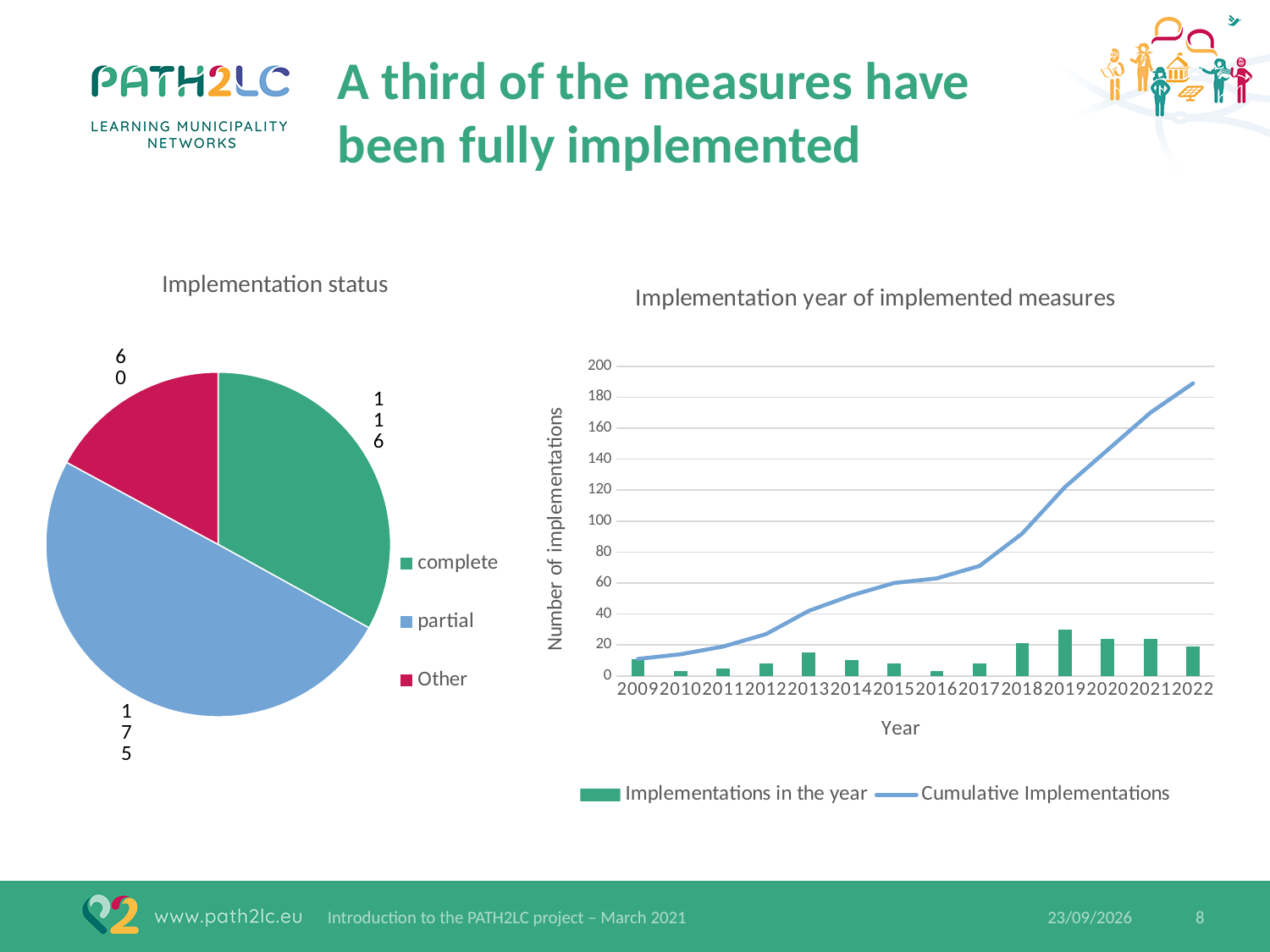
In the Implementation status pie chart, what is the value for complete? 116 In the chart titled Implementation year of implemented measures, is the Cumulative Implementations value for 2022 greater or less than 180? greater In the Implementation status pie chart, how many categories does the legend list? 3 In the Implementation status pie chart, which category has the smallest slice? Other In the Implementation status pie chart, what is the difference between the partial and complete values? 59 In the Implementation status pie chart, which category has the largest slice? partial In the Implementation status pie chart, what is the value for Other? 60 In the chart titled Implementation year of implemented measures, how many years are shown on the x axis? 14 In the chart titled Implementation year of implemented measures, which year has the tallest bar for Implementations in the year? 2019 In the Implementation status pie chart, what is the value for partial? 175 In the chart titled Implementation year of implemented measures, does the Cumulative Implementations line rise or fall from 2009 to 2022? rise In the chart titled Implementation year of implemented measures, how many series does the legend list? 2